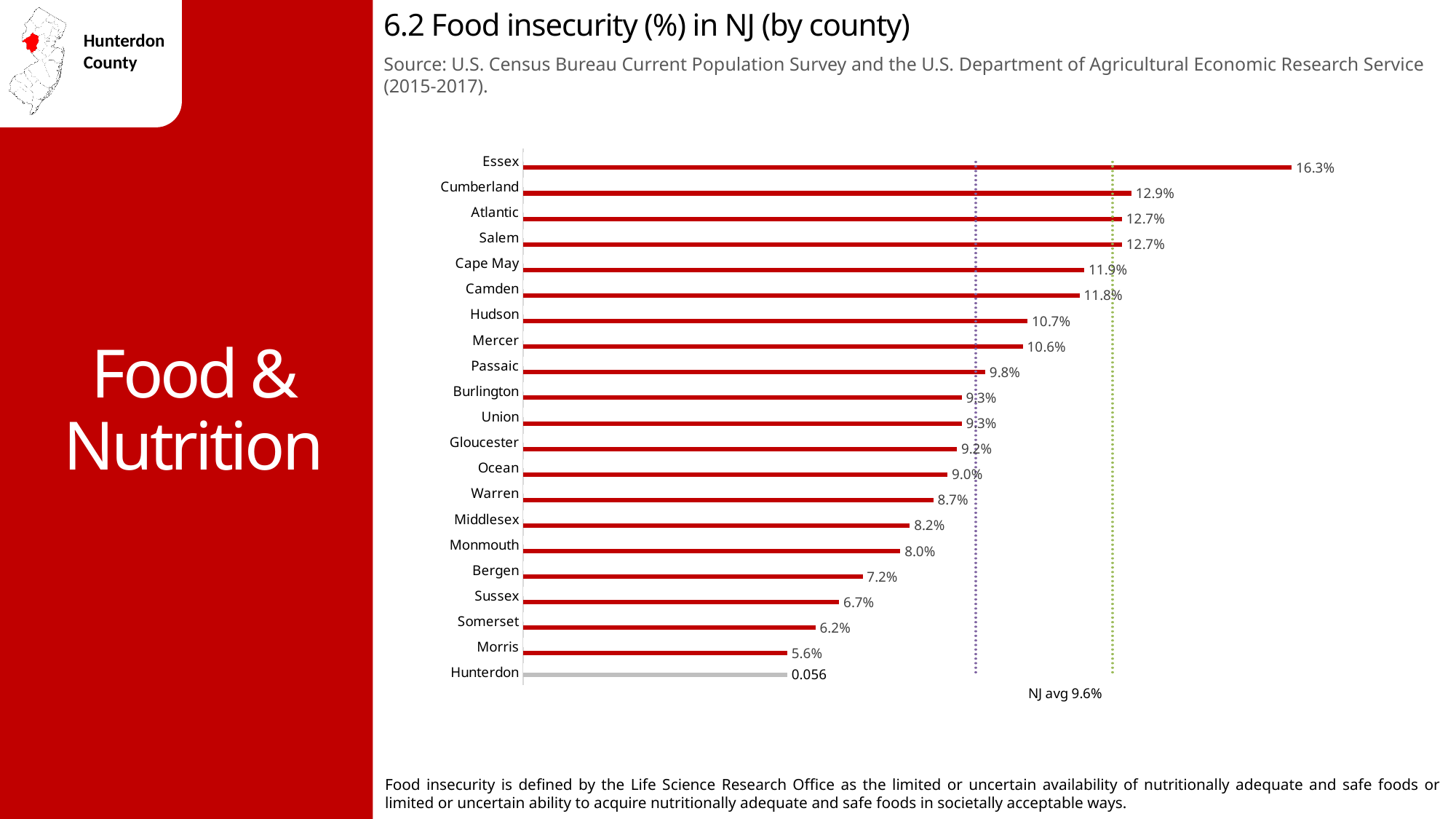
What value is labeled for Hunterdon on the chart? 0.056 What kind of chart is shown on the slide? Bar chart What is the food insecurity value for Bergen? 7.2% What NJ average value is labeled on the chart? 9.6% Which has a lower food insecurity value, Somerset or Monmouth? Somerset What is the food insecurity value shown for Essex? 16.3% How many counties are shown on the chart? 21 What is the difference between the values for Bergen and Sussex? 0.5% What is the difference between the values for Essex and Cumberland? 3.4% Which county has the highest food insecurity value on the chart? Essex What is the food insecurity value for Mercer? 10.6% Which has a higher food insecurity value, Passaic or Warren? Passaic